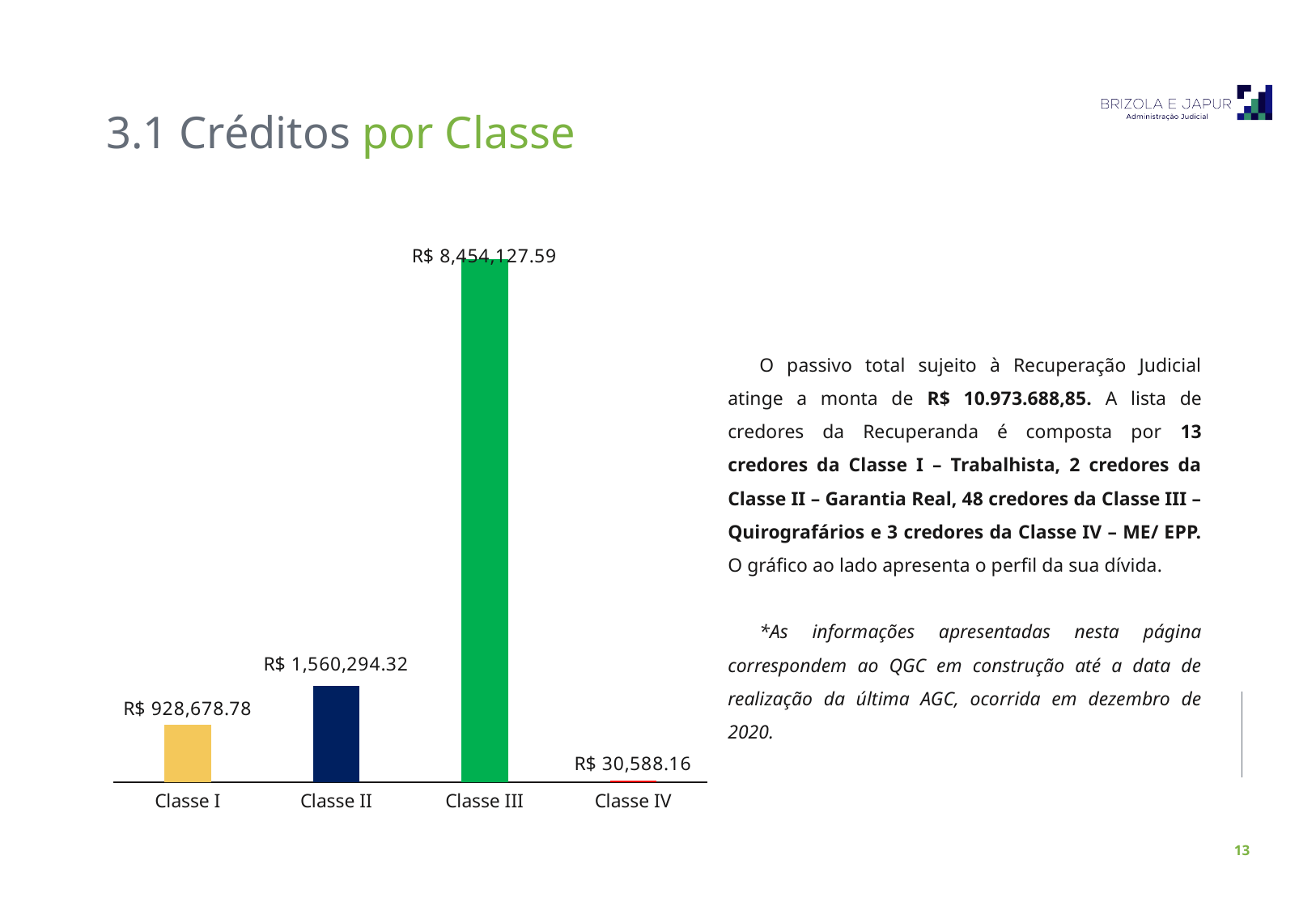
Which is larger, the value for Classe I or the value for Classe IV? Classe I Which class has the lowest value in the chart? Classe IV What colour is the bar for Classe III? Green What is the difference between the values for Classe III and Classe II? R$ 6,893,833.27 How many classes are shown in the chart? 4 What type of chart is shown on the slide? Bar chart Which class has the highest value in the chart? Classe III What is the value shown for Classe I? R$ 928,678.78 What is the value shown for Classe IV? R$ 30,588.16 What is the difference between the values for Classe II and Classe I? R$ 631,615.54 What is the value shown for Classe II? R$ 1,560,294.32 What is the value shown for Classe III? R$ 8,454,127.59